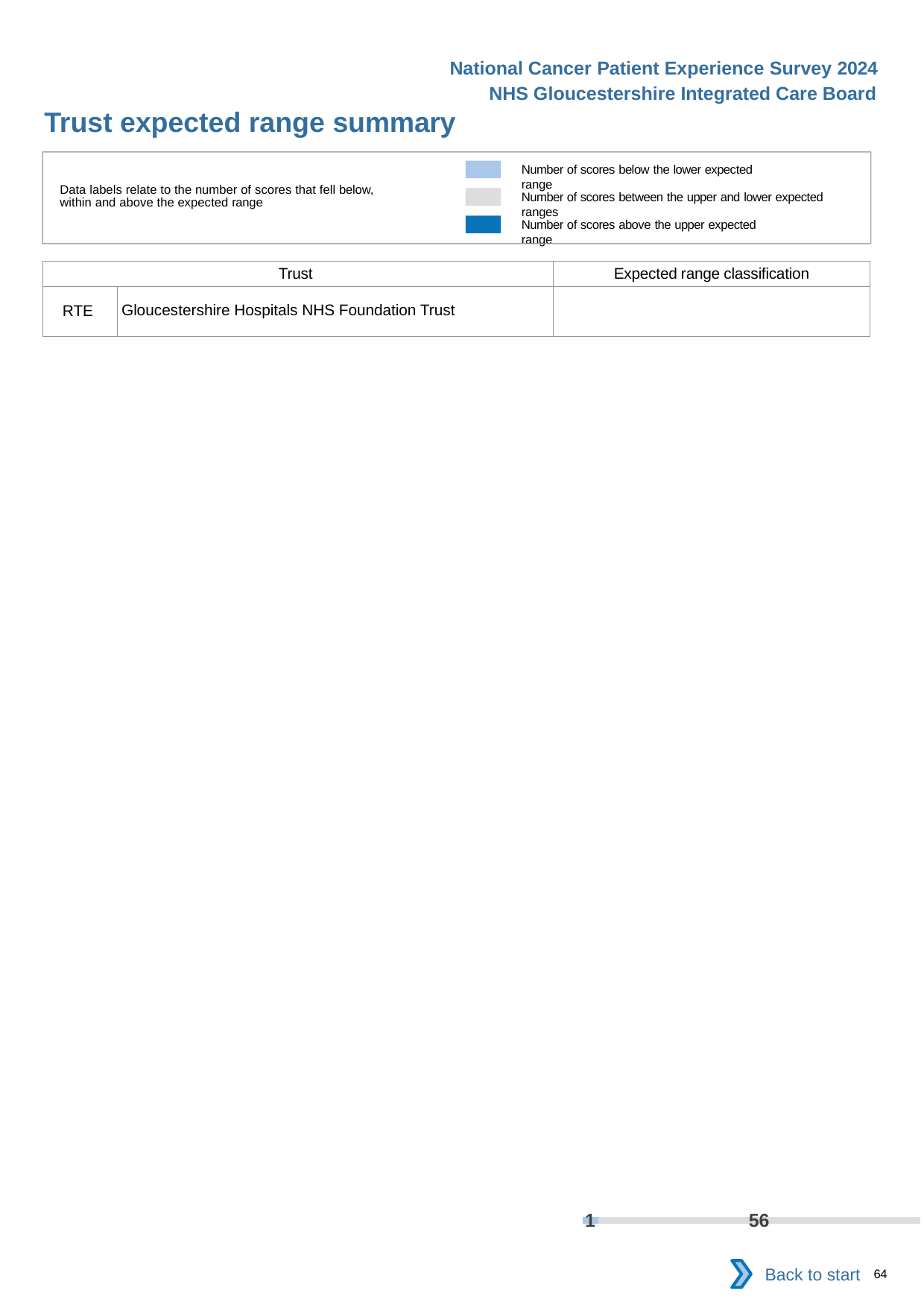
What kind of chart is shown at the bottom of the slide? Stacked bar chart In the stacked bar at the bottom of the slide, which is larger: the number of scores below the lower expected range or the number of scores between the expected ranges? Between the expected ranges Which trust does the expected range summary on this slide relate to? Gloucestershire Hospitals NHS Foundation Trust In the stacked bar at the bottom of the slide, what is the data label on the light blue segment (number of scores below the lower expected range)? 1 In the stacked bar at the bottom of the slide, what is the difference between the number of scores between the expected ranges and the number of scores below the lower expected range? 55 What is the title of this slide? Trust expected range summary How many categories does the legend at the top of the slide list? 3 In the stacked bar at the bottom of the slide, what is the data label on the grey segment (number of scores between the upper and lower expected ranges)? 56